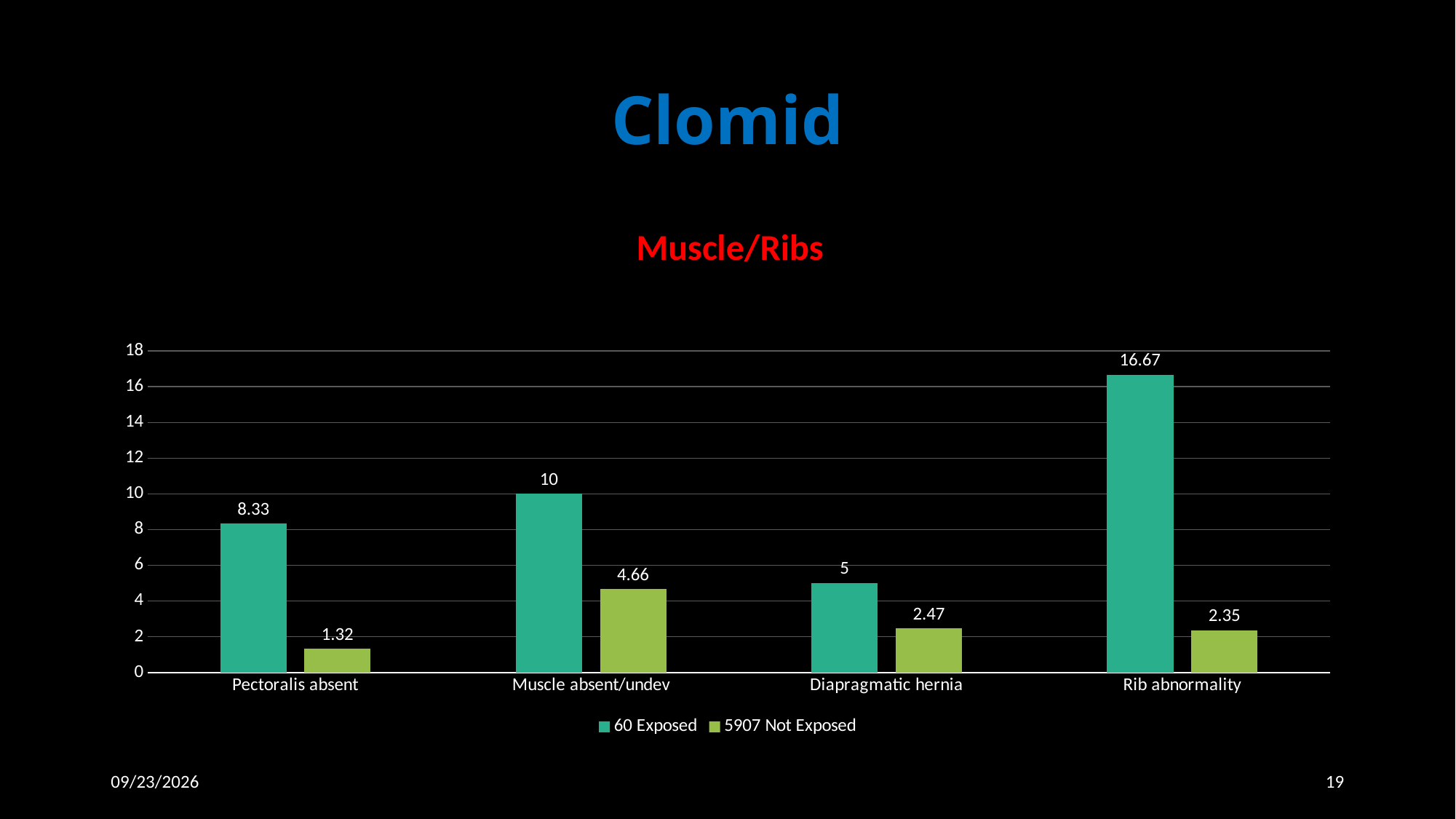
How many series does the legend list? 2 What is the value for Rib abnormality in the 60 Exposed series? 16.67 What is the title of the chart? Muscle/Ribs What is the difference between the 60 Exposed and 5907 Not Exposed values for Diapragmatic hernia? 2.53 Which is larger for Muscle absent/undev: the 60 Exposed value or the 5907 Not Exposed value? 60 Exposed Which category has the highest value in the 60 Exposed series? Rib abnormality Which category has the lowest value in the 5907 Not Exposed series? Pectoralis absent Is the 60 Exposed value for Pectoralis absent greater or less than 6? greater What is the value for Pectoralis absent in the 5907 Not Exposed series? 1.32 What is the value for Muscle absent/undev in the 5907 Not Exposed series? 4.66 What kind of chart is shown on the slide? Bar chart How many categories are shown on the x axis? 4